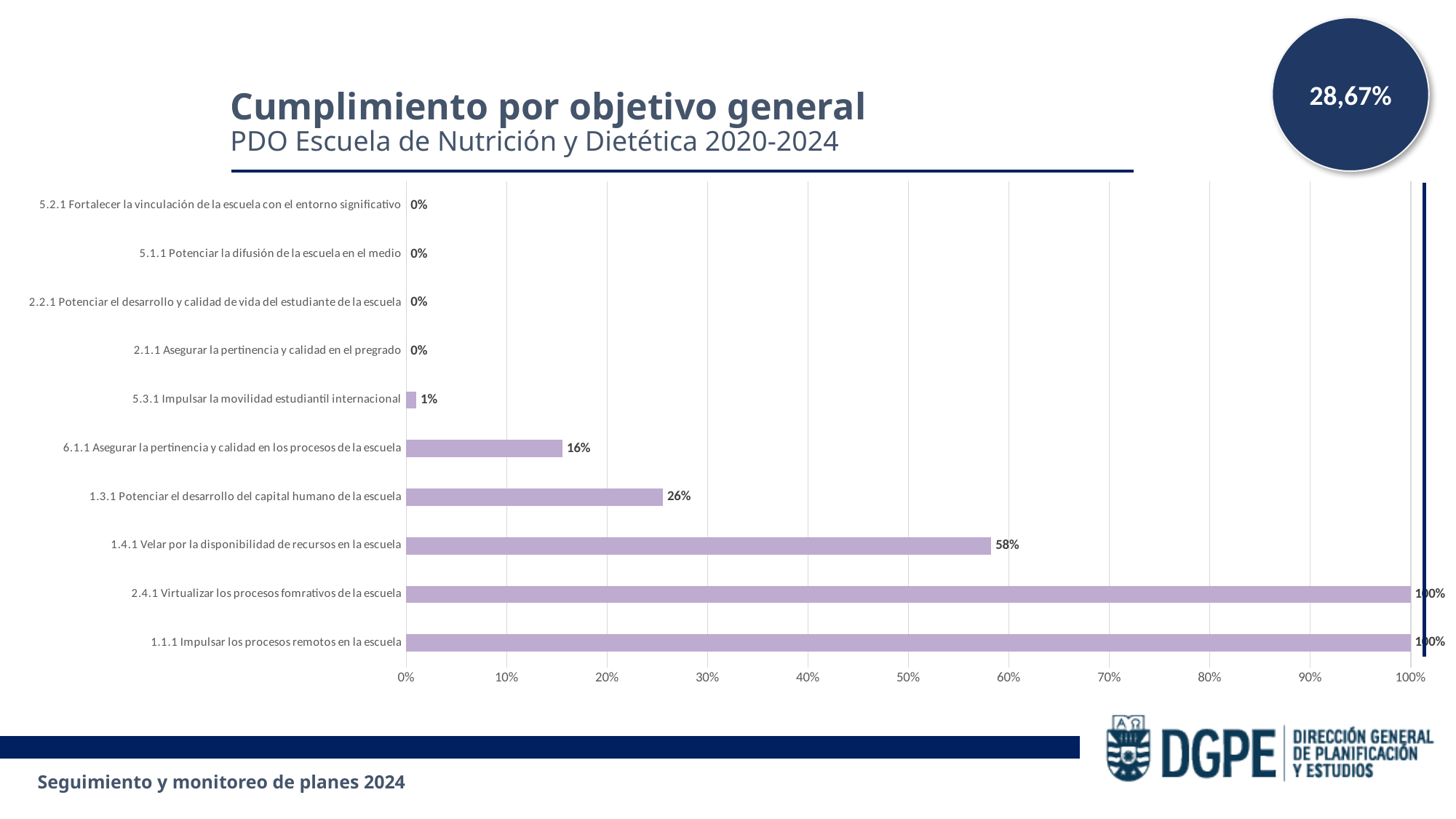
What is the title of the chart? Cumplimiento por objetivo general What is the difference between the values for 1.4.1 Velar por la disponibilidad de recursos en la escuela and 1.3.1 Potenciar el desarrollo del capital humano de la escuela? 32% What is the value for 5.3.1 Impulsar la movilidad estudiantil internacional? 1% What is the value for 1.4.1 Velar por la disponibilidad de recursos en la escuela? 58% What kind of chart is shown on the slide? bar chart How many categories are shown in the chart? 10 What is the value for 6.1.1 Asegurar la pertinencia y calidad en los procesos de la escuela? 16% Which is larger, the value for 6.1.1 Asegurar la pertinencia y calidad en los procesos de la escuela or the value for 1.3.1 Potenciar el desarrollo del capital humano de la escuela? 1.3.1 Potenciar el desarrollo del capital humano de la escuela How many categories have a value of 0%? 4 What is the value for 2.4.1 Virtualizar los procesos fomrativos de la escuela? 100% What is the value for 1.3.1 Potenciar el desarrollo del capital humano de la escuela? 26% Is the value for 1.4.1 Velar por la disponibilidad de recursos en la escuela greater or less than 50%? greater